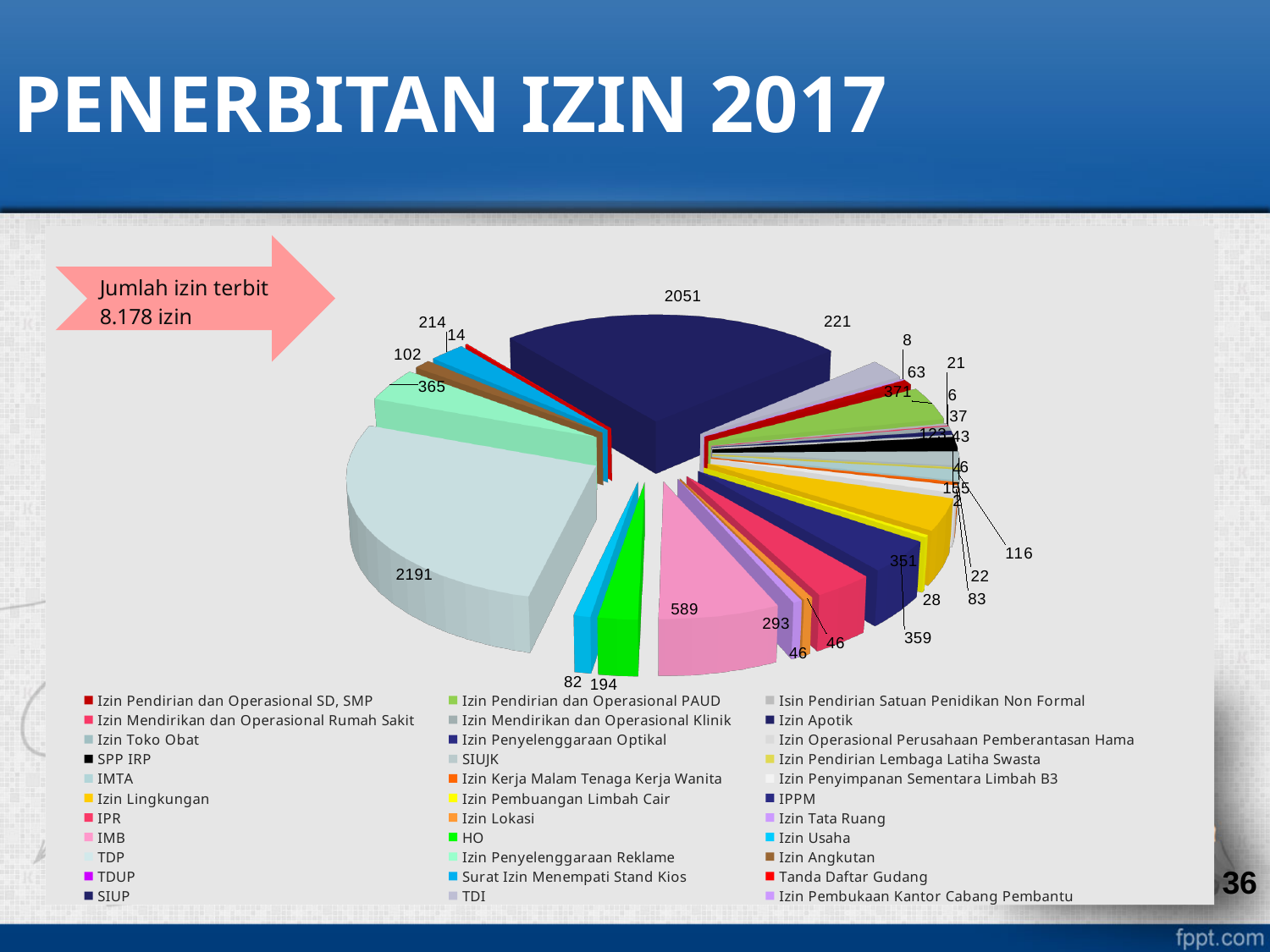
What is the title of the slide containing the chart? PENERBITAN IZIN 2017 Which is larger, the slice labelled 2191 or the slice labelled 2051? 2191 What is the largest value printed on any slice of the pie chart? 2191 What is the difference between the two largest slice values printed on the pie chart, 2191 and 2051? 140 What is the second-largest value printed on the pie chart? 2051 What kind of chart is shown on the slide? pie chart Which is larger, the slice labelled 589 or the slice labelled 293? 589 Is the value of the slice labelled 589 greater or less than 500? greater How many entries does the legend of the pie chart list? 33 According to the callout on the slide, what is the total number of permits issued (jumlah izin terbit)? 8.178 izin